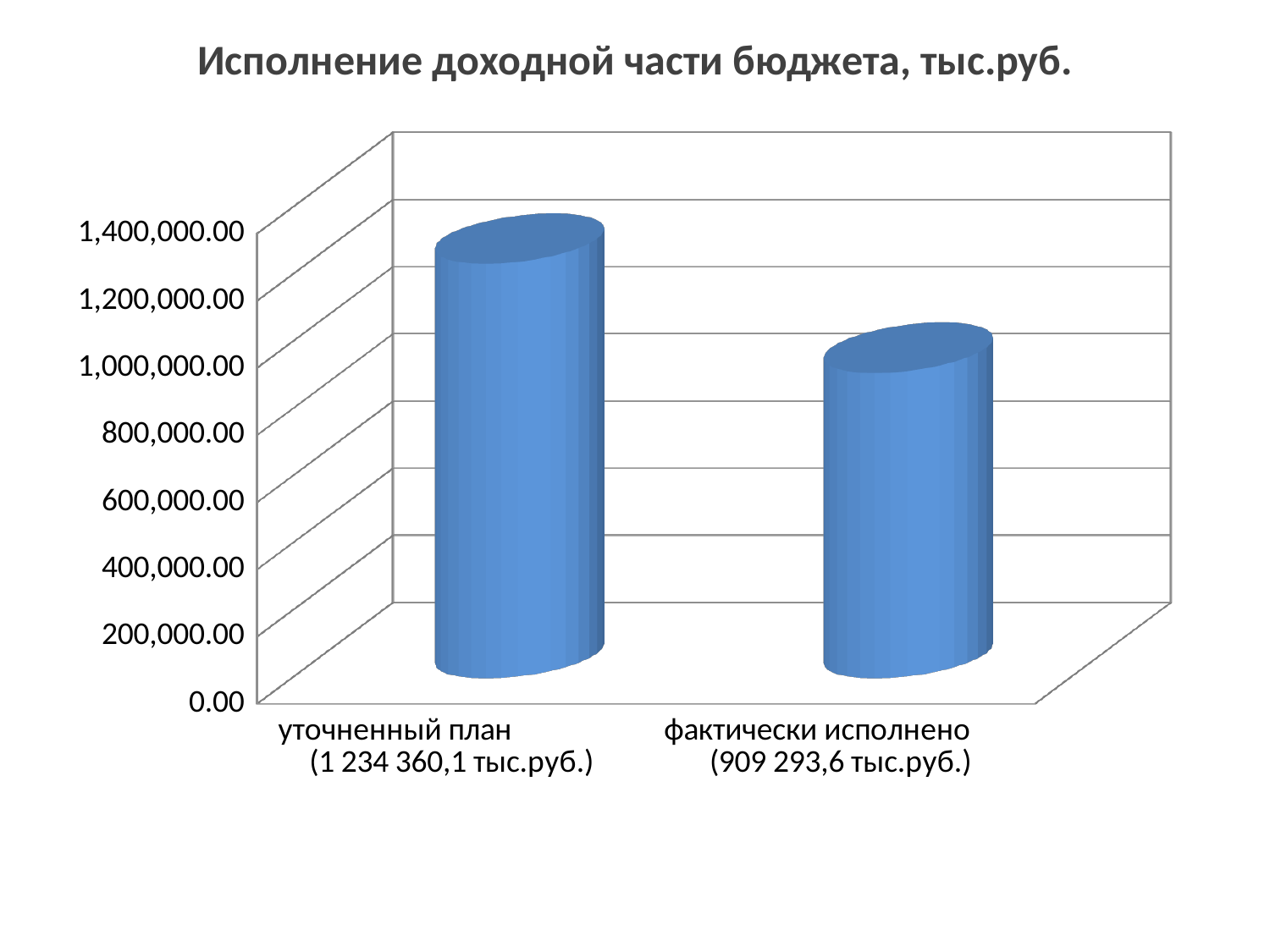
What value is given for "уточненный план"? 1 234 360,1 тыс.руб. Do the values rise or fall from left to right along the x axis? fall What is the title of the chart? Исполнение доходной части бюджета, тыс.руб. What kind of chart is shown on the slide? bar chart What is the difference between the value for "уточненный план" and the value for "фактически исполнено"? 325 066,5 тыс.руб. How many categories are plotted in the chart? 2 Which is larger, the value for "уточненный план" or the value for "фактически исполнено"? уточненный план What value is given for "фактически исполнено"? 909 293,6 тыс.руб. Is the value for "фактически исполнено" greater or less than 1,200,000.00? less Which category has the lowest value? фактически исполнено Which category has the highest value? уточненный план Is the value for "уточненный план" greater or less than 1,000,000.00? greater